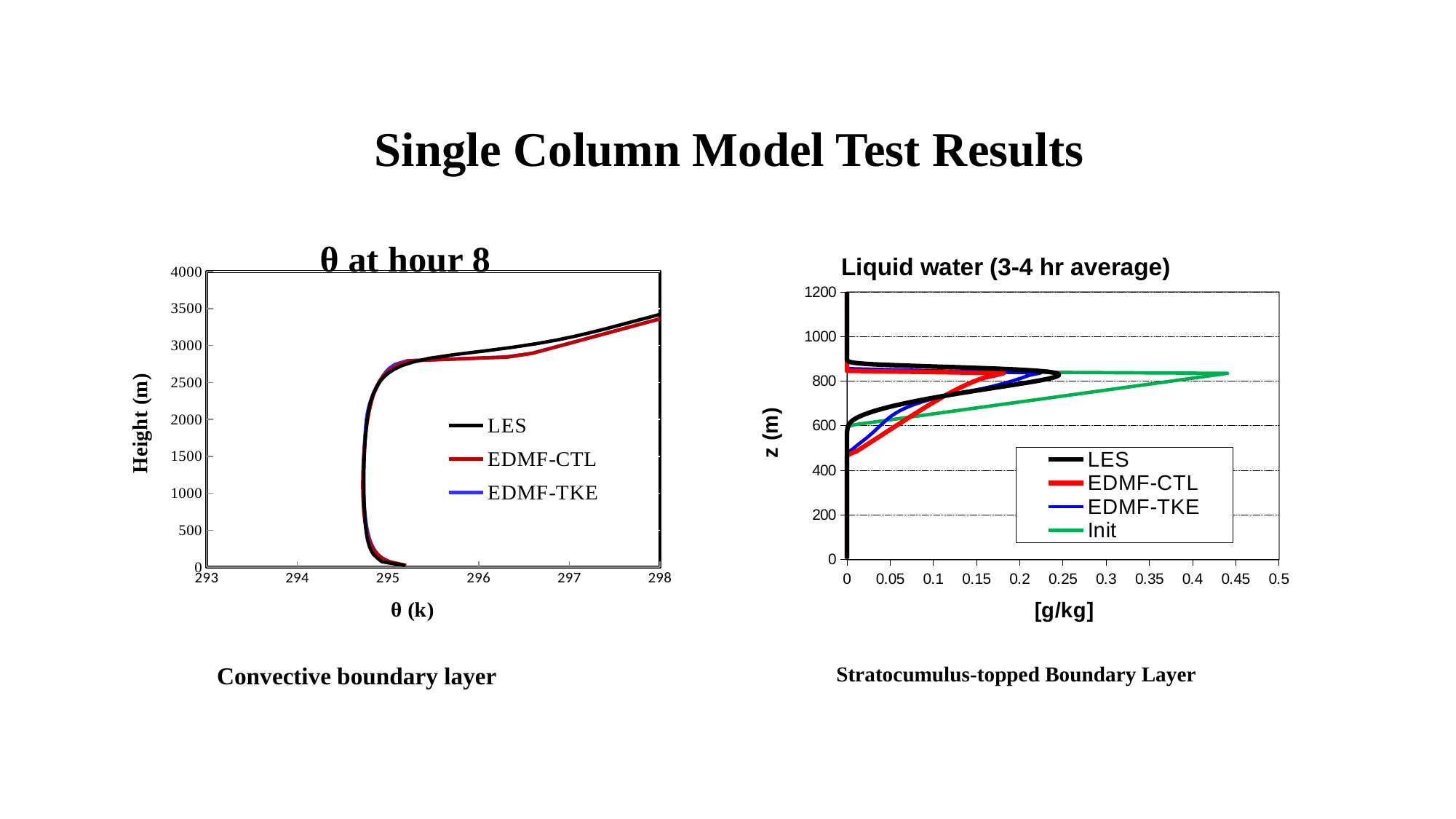
What is the y-axis label of the 'Liquid water (3-4 hr average)' chart? z (m) How many series does the legend of the 'θ at hour 8' chart list? 3 In the 'Liquid water (3-4 hr average)' chart, is the peak value of the LES series greater or less than 0.3 g/kg? less What kind of chart is the 'Liquid water (3-4 hr average)' chart on the right? line chart How many series does the legend of the 'Liquid water (3-4 hr average)' chart list? 4 In the 'θ at hour 8' chart, is the value of θ at a height of 1500 m greater or less than 296 K? less In the 'Liquid water (3-4 hr average)' chart, is the peak value of the Init series greater or less than 0.4 g/kg? greater In the 'Liquid water (3-4 hr average)' chart, which series reaches the highest liquid water value? Init What is the x-axis label of the 'θ at hour 8' chart? θ (k) In the 'Liquid water (3-4 hr average)' chart, which series has a higher peak liquid water value, LES or EDMF-CTL? LES What kind of chart is the 'θ at hour 8' chart on the left? line chart